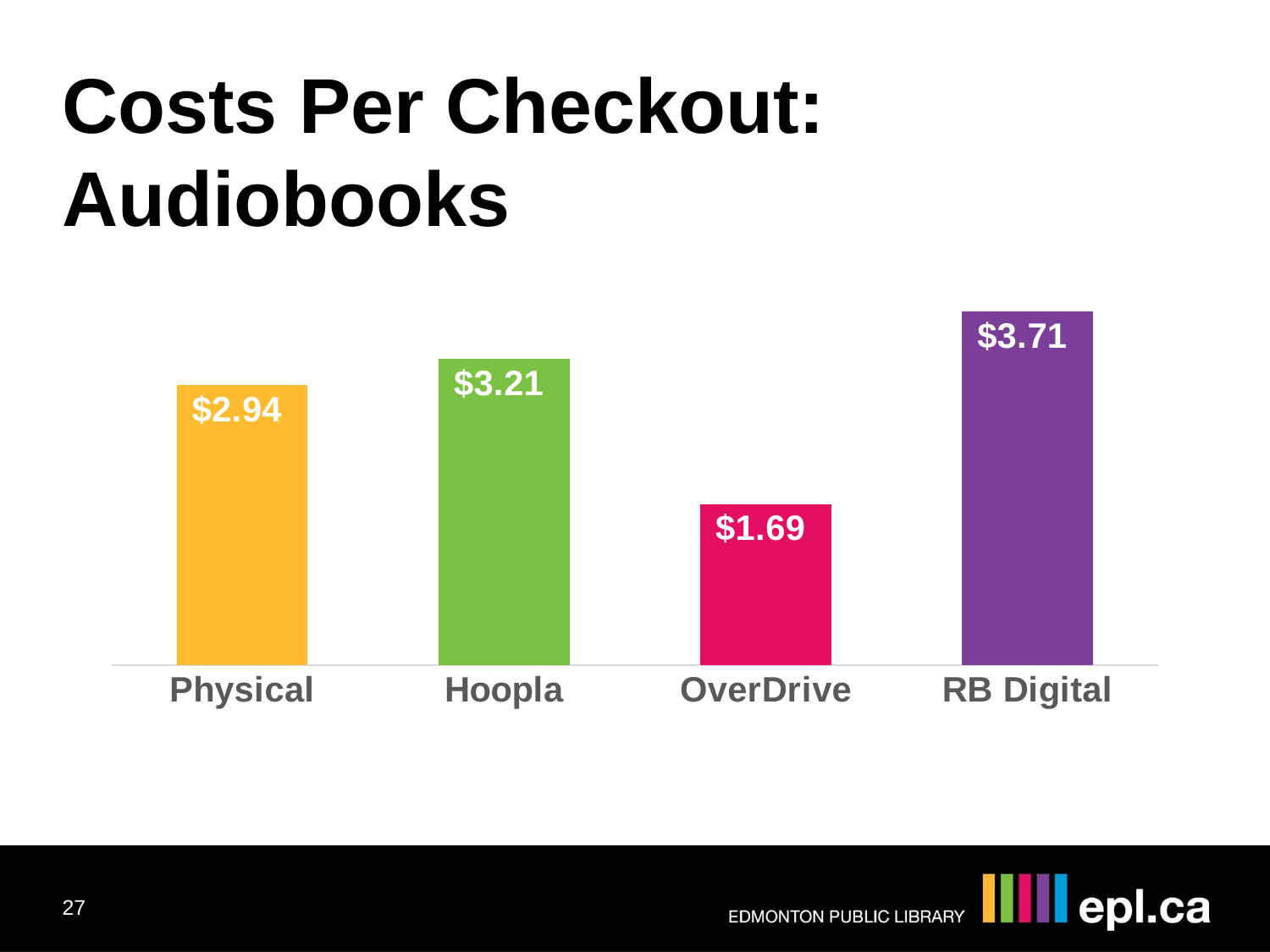
Which category has the lowest cost per checkout? OverDrive What kind of chart is shown on the slide? Bar chart How many categories are shown in the chart? 4 What is the difference in cost per checkout between RB Digital and OverDrive? $2.02 Which category has the highest cost per checkout? RB Digital What is the difference in cost per checkout between Hoopla and Physical? $0.27 What is the cost per checkout for OverDrive? $1.69 What is the cost per checkout for Hoopla? $3.21 What is the cost per checkout for RB Digital? $3.71 Which has a higher cost per checkout, Physical or Hoopla? Hoopla What is the title of the slide containing the chart? Costs Per Checkout: Audiobooks What is the cost per checkout for Physical audiobooks? $2.94